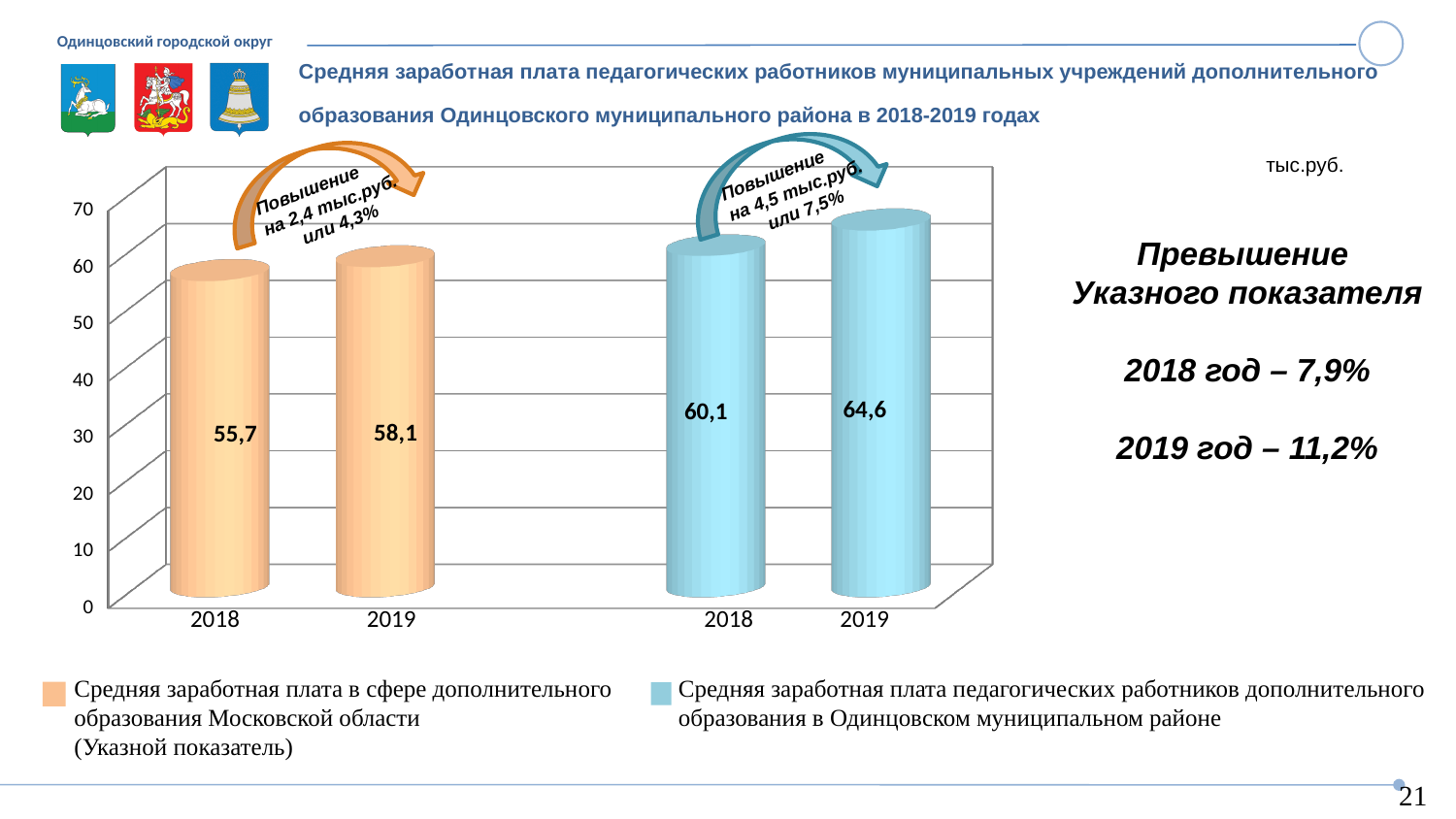
Which bar has the lowest value on the chart? 2018, Московская область (55,7) Which is larger: the 2018 value for Московская область or the 2018 value for Одинцовский муниципальный район? Одинцовский муниципальный район (60,1) Is the 2019 value for Одинцовский муниципальный район greater or less than 60? greater How many series does the legend list? 2 What is the value for 2019 in the blue series (Средняя заработная плата педагогических работников дополнительного образования в Одинцовском муниципальном районе)? 64,6 What is the value for 2018 in the blue series (Одинцовском муниципальном районе)? 60,1 What is the difference between the 2019 and 2018 values in the blue series (Одинцовский муниципальный район)? 4,5 What is the value for 2019 in the orange series (Московской области, Указной показатель)? 58,1 Which bar has the highest value on the chart? 2019, Одинцовский муниципальный район (64,6) What is the difference between the 2019 and 2018 values in the orange series (Московская область)? 2,4 What type of chart is shown on the slide? Bar chart What is the value for 2018 in the orange series (Средняя заработная плата в сфере дополнительного образования Московской области)? 55,7